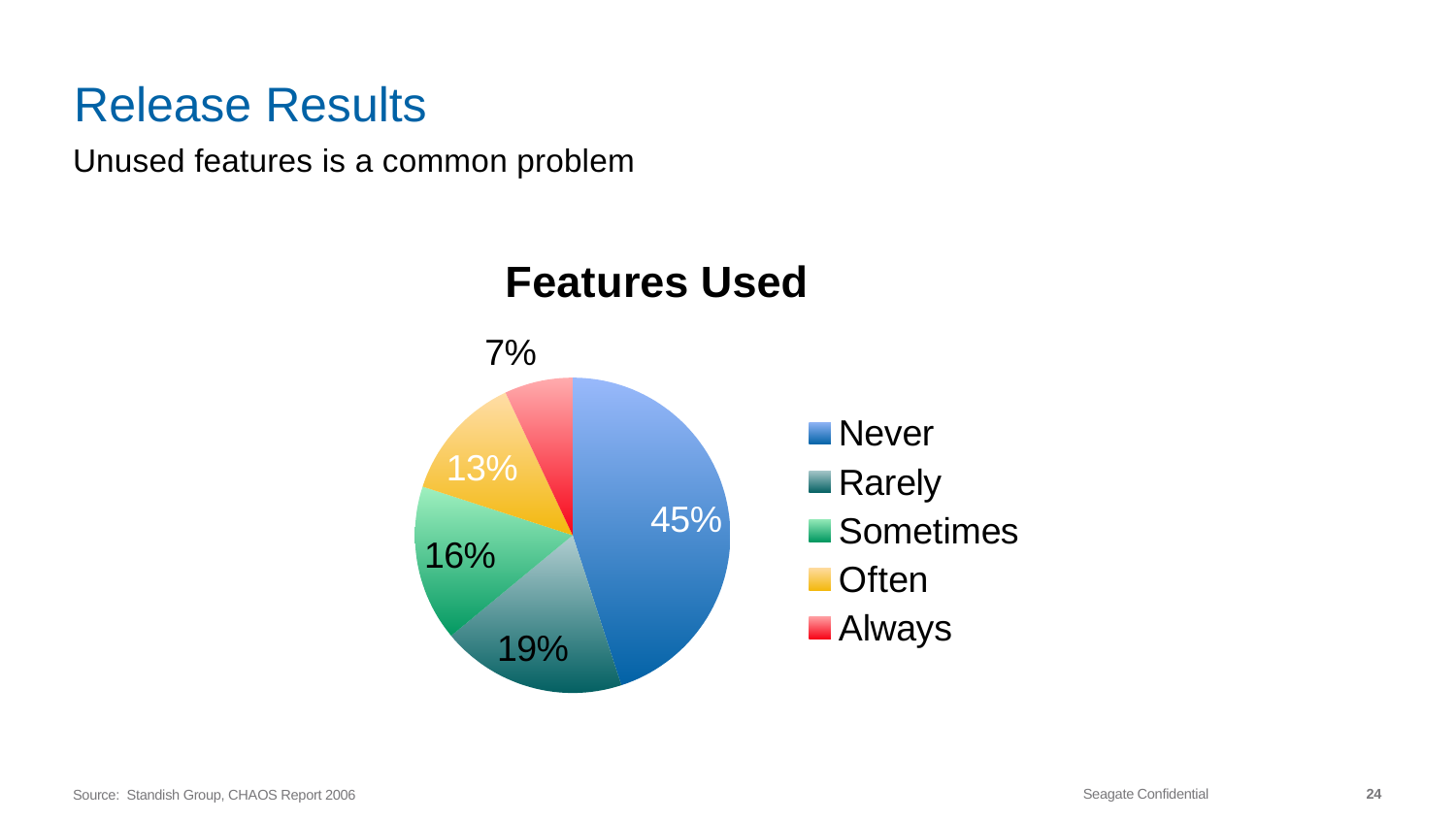
What is the difference in percentage points between the Never and Rarely slices? 26 What percentage of the pie chart is labelled Never? 45% What percentage of the pie chart is labelled Often? 13% How many categories does the pie chart show? 5 What percentage of the pie chart is labelled Sometimes? 16% What percentage of the pie chart is labelled Rarely? 19% Which category has the largest share of the pie chart? Never What percentage of the pie chart is labelled Always? 7% Which slice is larger, Sometimes or Often? Sometimes Which category has the smallest share of the pie chart? Always What kind of chart is shown on the slide? Pie chart What is the title of the chart? Features Used